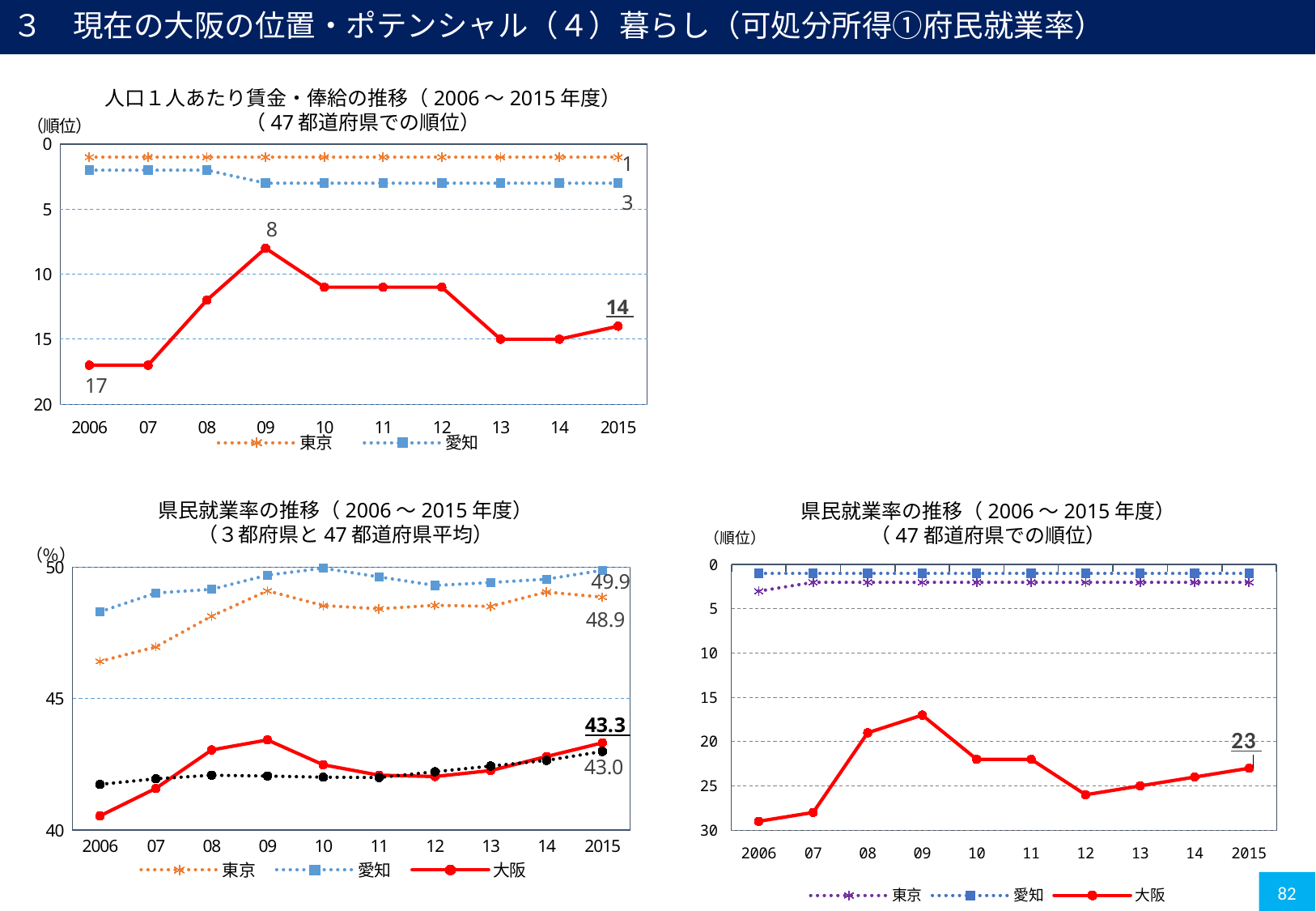
In the top-left chart (人口１人あたり賃金・俸給の推移), what value is labelled on the red line in 2006? 17 In the bottom-left chart (県民就業率の推移, 3都府県と47都道府県平均), what is the value for 東京 in 2015? 48.9 In the bottom-left chart (県民就業率の推移, 3都府県と47都道府県平均), how many series does the legend list? 3 In the bottom-left chart (県民就業率の推移, 3都府県と47都道府県平均), what is the value for 愛知 in 2015? 49.9 In the top-left chart (人口１人あたり賃金・俸給の推移), what value is labelled on the red line in 2009? 8 In the top-left chart (人口１人あたり賃金・俸給の推移), what value is labelled on the red line in 2015? 14 In the bottom-right chart (県民就業率の推移, 47都道府県での順位), what is the rank shown for 大阪 in 2015? 23 In the bottom-left chart (県民就業率の推移, 3都府県と47都道府県平均), what is the value for 大阪 in 2015? 43.3 In the top-left chart (人口１人あたり賃金・俸給の推移), what is the rank shown for 東京 in 2015? 1 In the top-left chart (人口１人あたり賃金・俸給の推移), what is the rank shown for 愛知 in 2015? 3 In the top-left chart (人口１人あたり賃金・俸給の推移), what is the difference between the red line's labelled values in 2006 and 2015? 3 What kind of chart is the bottom-right chart (県民就業率の推移, 47都道府県での順位)? Line chart